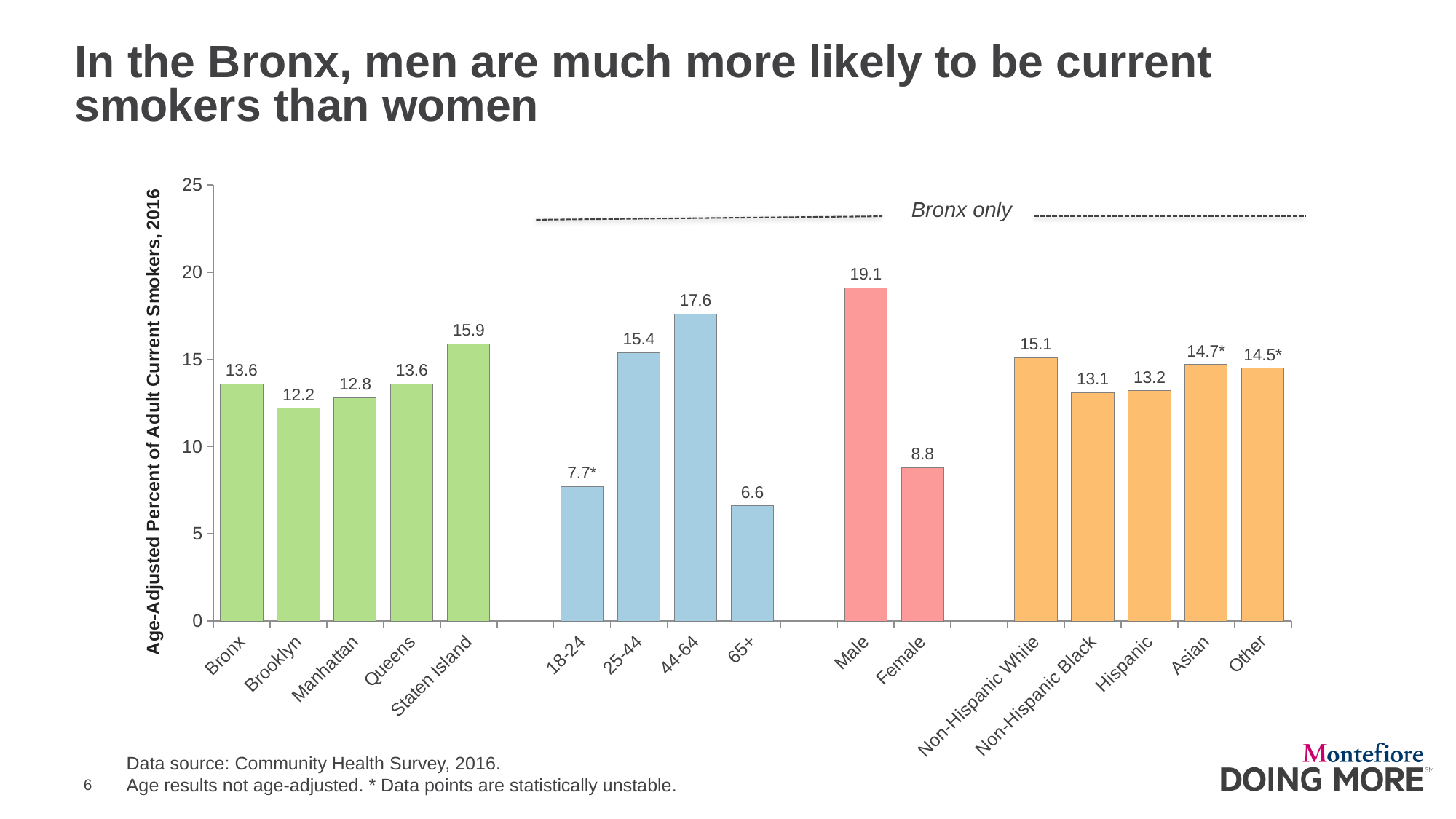
Which bar on the chart has the highest value? Male What type of chart is shown on the slide? Bar chart What is the value shown for Non-Hispanic Black? 13.1 What is the difference between the Male and Female values? 10.3 What is the value shown for Male? 19.1 What is the value shown for the 65+ age group? 6.6 What is the age-adjusted percent of adult current smokers for Staten Island? 15.9 What is the label of the y axis? Age-Adjusted Percent of Adult Current Smokers, 2016 What is the difference between the 44-64 and 25-44 age group values? 2.2 Which is larger, the value for Hispanic or the value for Non-Hispanic White? Non-Hispanic White Which of the five boroughs has the lowest percent of adult current smokers? Brooklyn How many bars are plotted on the chart in total? 16